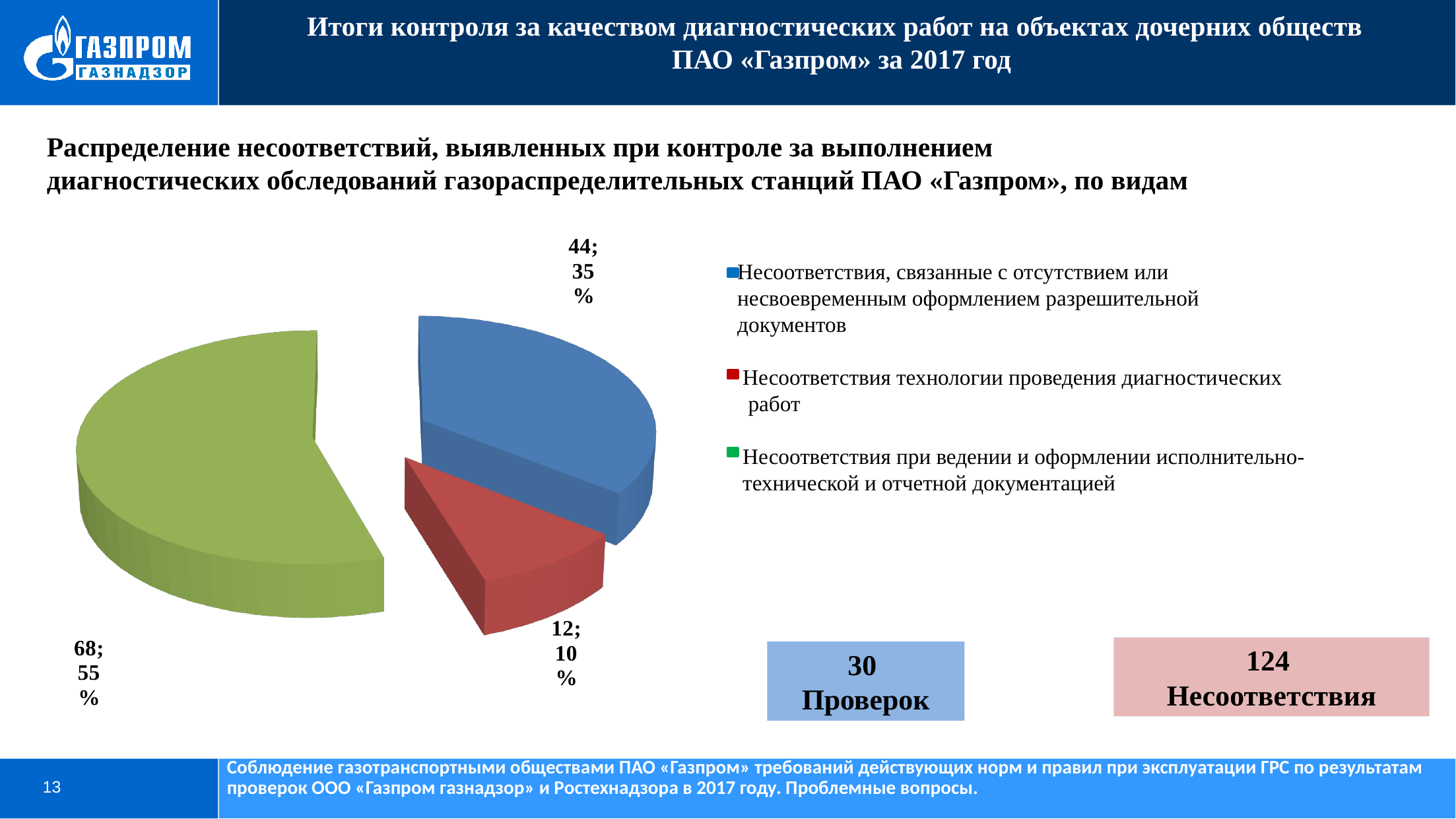
What is the total of the three slice values (44, 12 and 68)? 124 What is the value shown for the green slice (Несоответствия при ведении и оформлении исполнительно-технической и отчетной документацией)? 68 How many slices does the pie chart have? 3 Which category has the smallest slice of the pie chart? Несоответствия технологии проведения диагностических работ How many entries does the legend of the pie chart list? 3 What percentage share is shown for the blue slice (Несоответствия, связанные с отсутствием или несвоевременным оформлением разрешительной документов)? 35% What kind of chart is shown on the slide? pie chart Which is larger: the blue slice (разрешительной документов) or the red slice (технологии проведения диагностических работ)? the blue slice What is the difference between the value of the green slice (68) and the blue slice (44)? 24 What percentage share is shown for the green slice? 55% Which category has the largest slice of the pie chart? Несоответствия при ведении и оформлении исполнительно-технической и отчетной документацией What is the value shown for the red slice (Несоответствия технологии проведения диагностических работ)? 12